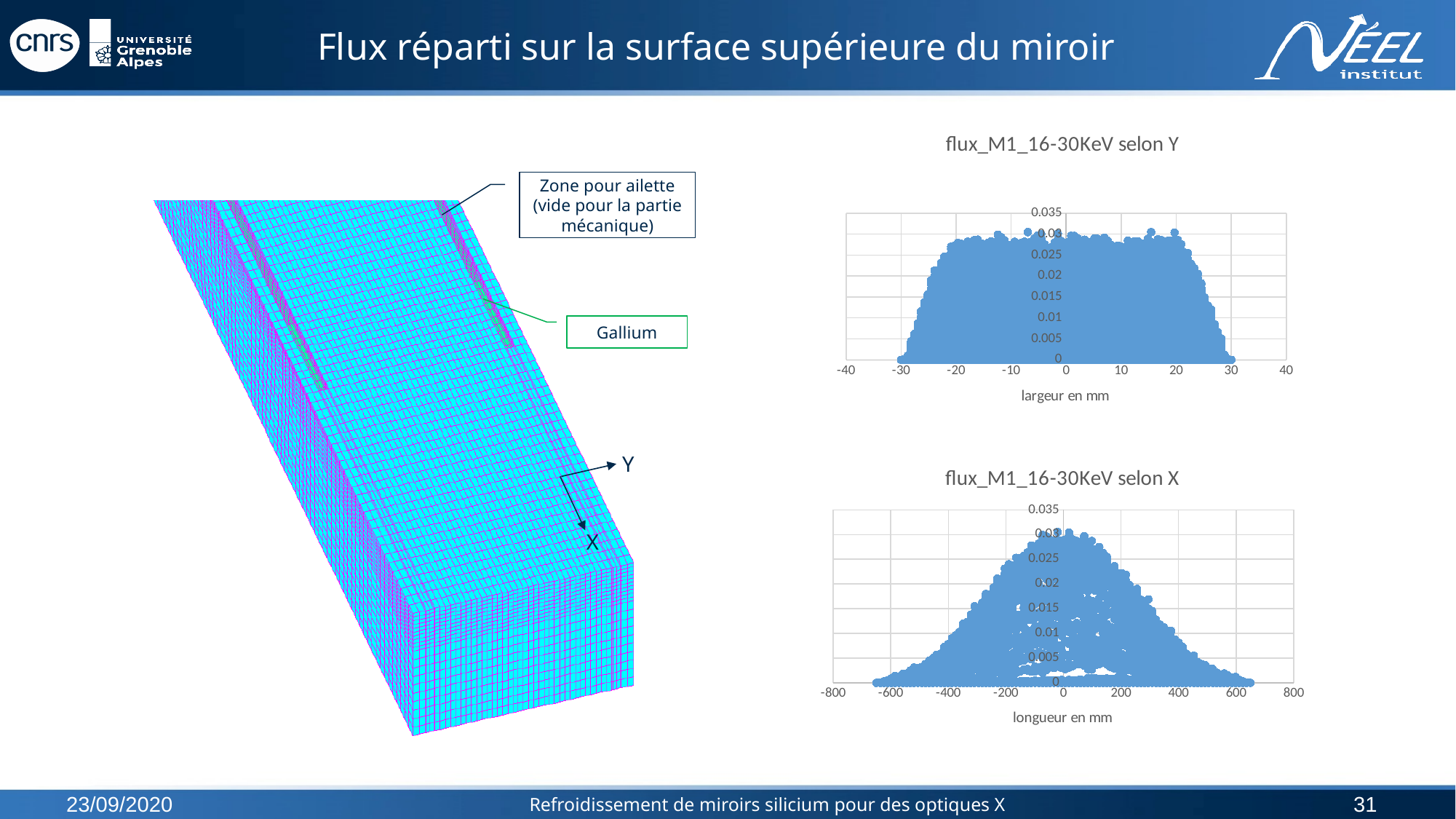
In the chart titled "flux_M1_16-30KeV selon X", is the highest plotted value greater or less than 0.02? greater What kind of chart is the chart titled "flux_M1_16-30KeV selon X"? scatter chart In the chart titled "flux_M1_16-30KeV selon X", is the highest plotted value greater or less than 0.035? less What kind of chart is the chart titled "flux_M1_16-30KeV selon Y"? scatter chart In the chart titled "flux_M1_16-30KeV selon X", do the values rise or fall as longueur goes from 0 to 600 mm? fall In the chart titled "flux_M1_16-30KeV selon Y", is the highest plotted value greater or less than 0.025? greater What is the x-axis label of the chart titled "flux_M1_16-30KeV selon Y"? largeur en mm In the chart titled "flux_M1_16-30KeV selon Y", do the values rise or fall as largeur goes from 20 to 30 mm? fall In the chart titled "flux_M1_16-30KeV selon X", do the values rise or fall as longueur goes from -600 to 0 mm? rise What is the x-axis label of the chart titled "flux_M1_16-30KeV selon X"? longueur en mm